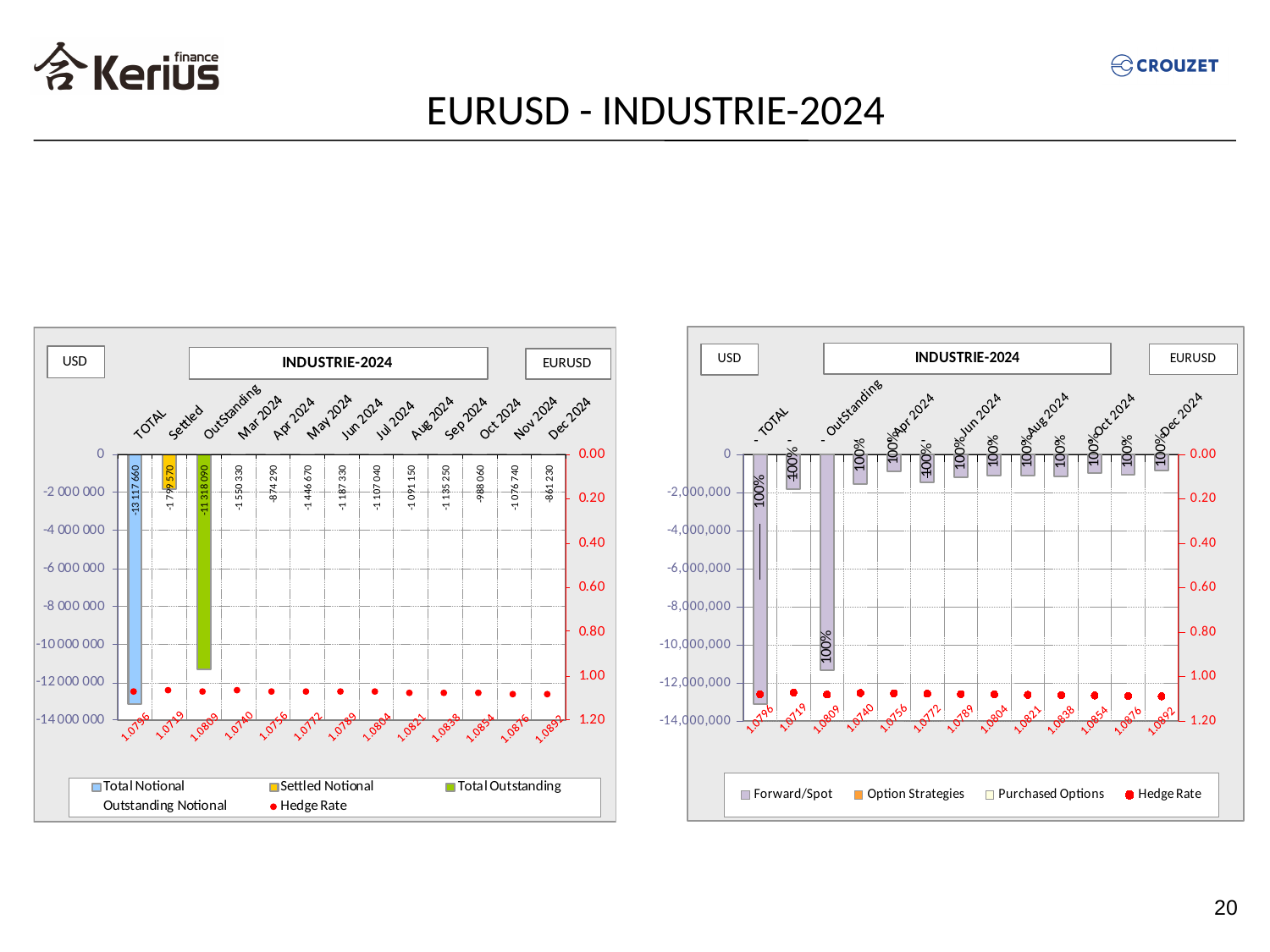
On the left chart, which month from Mar 2024 to Dec 2024 has the smallest negative notional value? Dec 2024 On the left chart, what is the Hedge Rate value shown for Dec 2024? 1.0892 How many entries does the legend of the left chart list? 5 On the right chart, what percentage label is shown on the OutStanding bar? 100% On the left chart, what is the data label for the Settled bar? -1 799 570 On the left chart, what is the data label for the OutStanding bar? -11 318 090 On the left chart, which month from Mar 2024 to Dec 2024 has the largest negative notional value? Mar 2024 On the left chart, what is the Hedge Rate value shown for Settled? 1.0719 On the left chart, what is the data label for Apr 2024? -874 290 On the left chart, what is the data label for the TOTAL bar? -13 117 660 How many entries does the legend of the right chart list? 4 On the left chart, what is the difference between the Mar 2024 value (-1 550 330) and the Apr 2024 value (-874 290)? 676 040